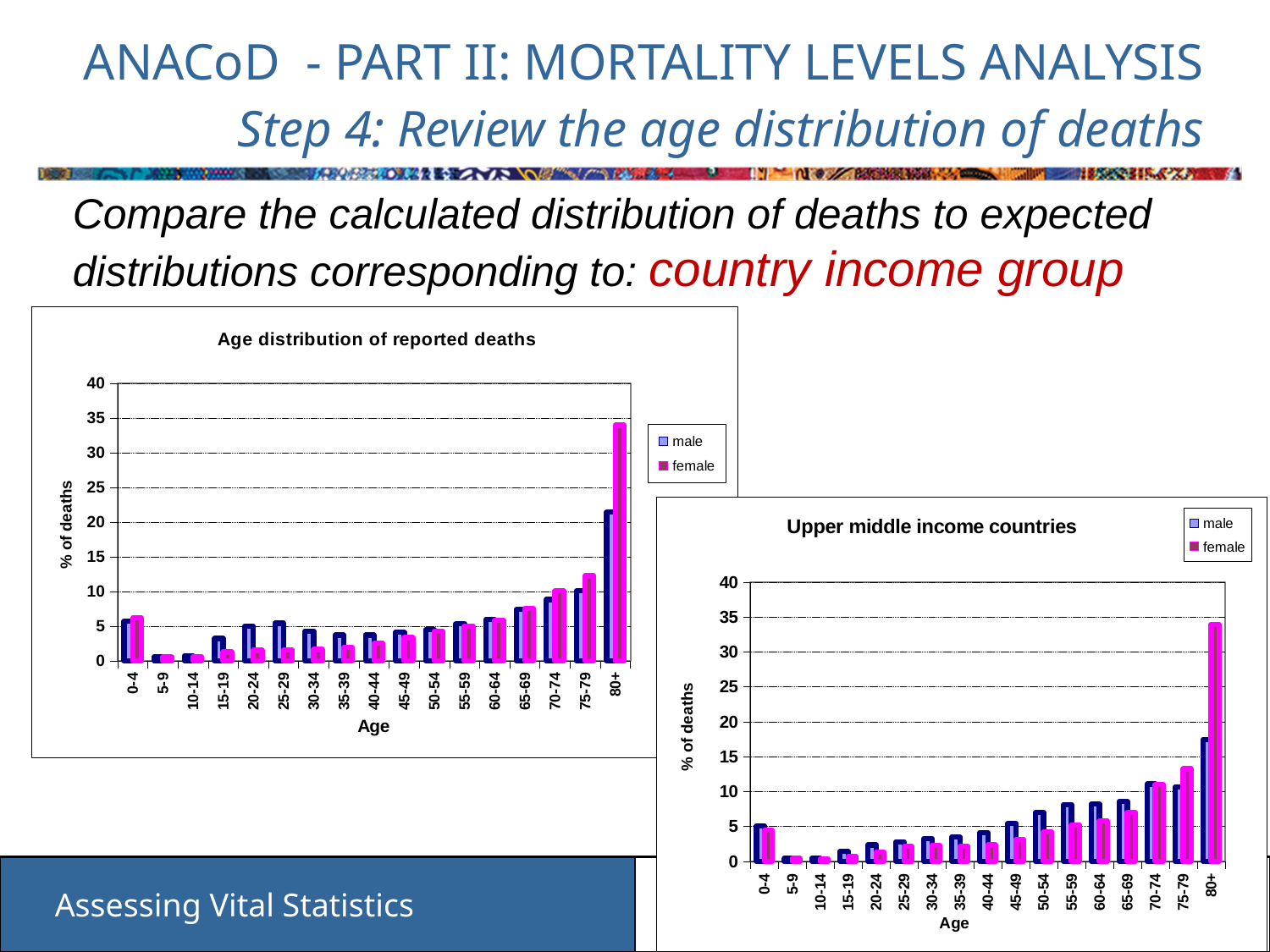
What kind of chart is the one titled 'Upper middle income countries'? bar chart In the chart titled 'Age distribution of reported deaths', which is larger for the 20-24 age group, male or female? male In the chart titled 'Age distribution of reported deaths', which age group has the highest value for female? 80+ In the chart titled 'Upper middle income countries', which is larger for the 55-59 age group, male or female? male In the chart titled 'Age distribution of reported deaths', is the male value for 80+ greater or less than 15? greater In the chart titled 'Upper middle income countries', do the male values generally rise or fall from the 15-19 age group to the 80+ age group? rise What is the y-axis label of the chart titled 'Upper middle income countries'? % of deaths In the chart titled 'Age distribution of reported deaths', is the female value for 80+ greater or less than 30? greater In the chart titled 'Upper middle income countries', is the male value for 80+ greater or less than 20? less In the chart titled 'Age distribution of reported deaths', how many age groups are shown on the x axis? 17 In the chart titled 'Age distribution of reported deaths', how many series does the legend list? 2